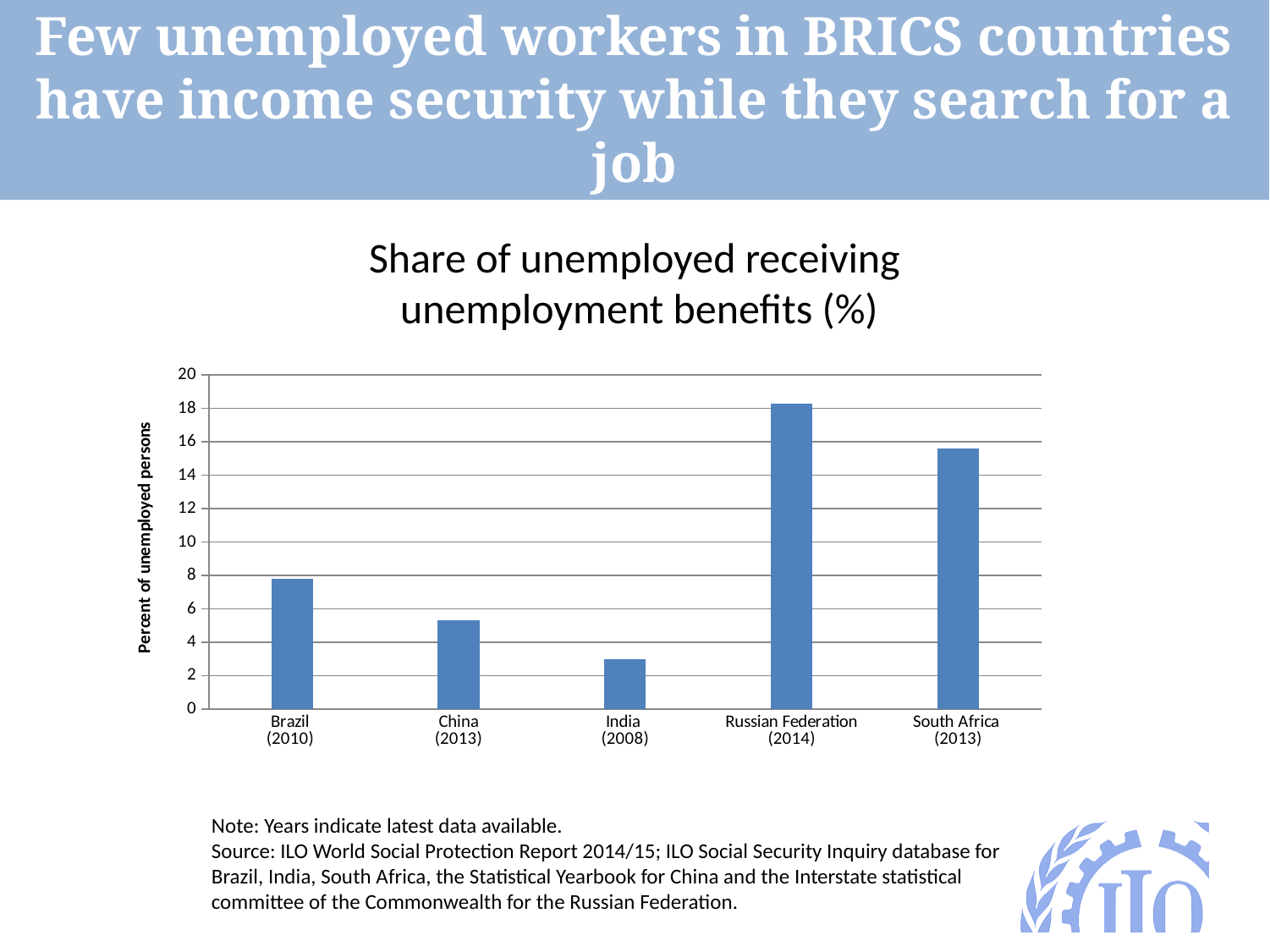
Which is larger, the value for Brazil or the value for China? Brazil Is the value for South Africa greater or less than 16? less Which is larger, the value for South Africa or the value for the Russian Federation? Russian Federation What kind of chart is shown on the slide? bar chart Which country has the lowest share of unemployed receiving unemployment benefits? India How many countries are shown on the x axis of the chart? 5 Which country has the highest share of unemployed receiving unemployment benefits? Russian Federation Is the value for the Russian Federation greater or less than 18? greater What is the title of the chart? Share of unemployed receiving unemployment benefits (%) Is the value for India greater or less than 4? less